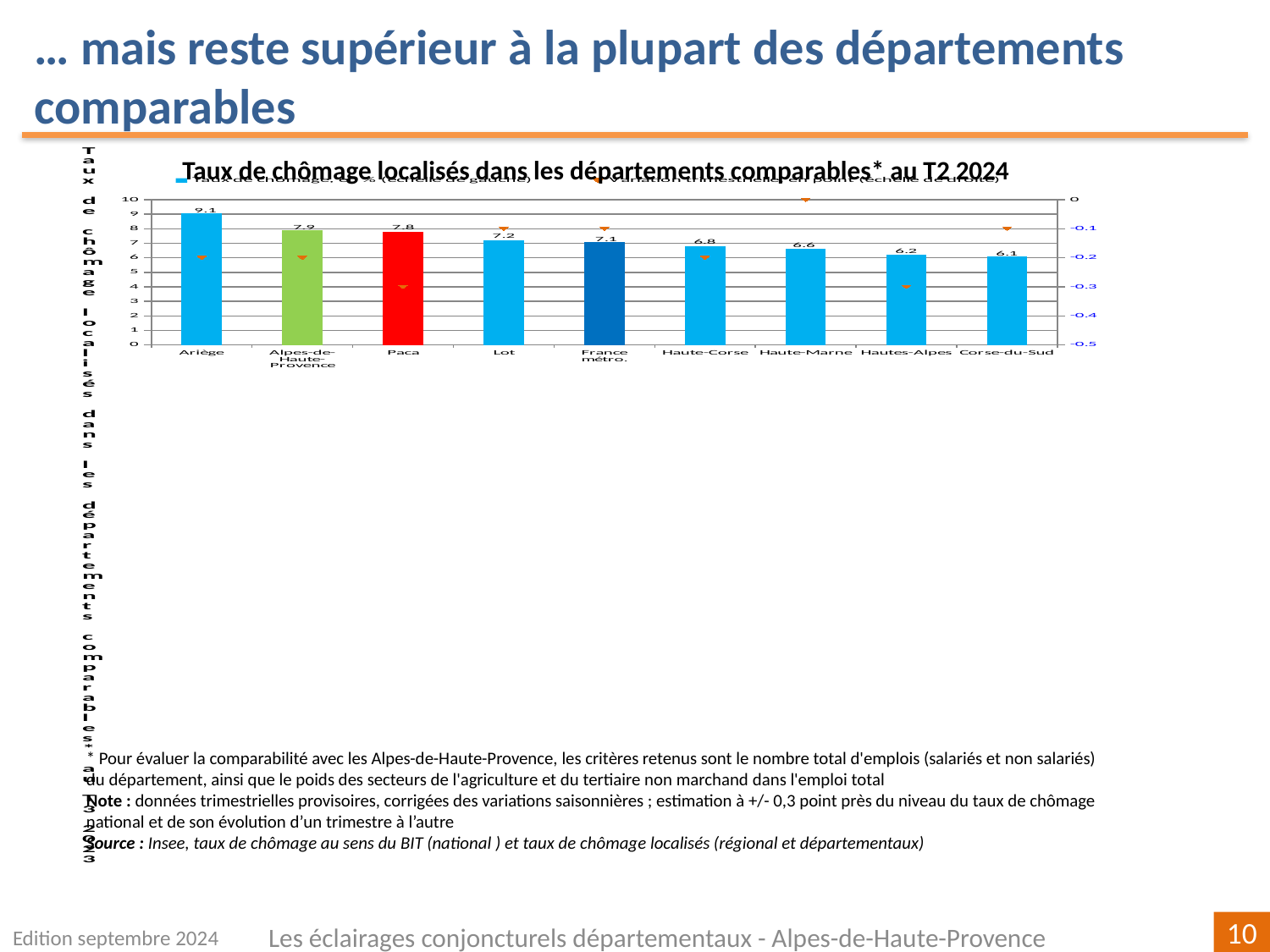
What type of chart is used to show the unemployment rates? Bar chart Which has a higher unemployment rate, Lot or Haute-Corse? Lot What is the value shown for Corse-du-Sud? 6.1 What is the unemployment rate shown for Ariège? 9.1 How many series does the chart legend list? 2 What is the difference between the unemployment rates of Ariège and Alpes-de-Haute-Provence? 1.2 Do the bar values rise or fall from left to right along the x axis? Fall What is the value shown for France métro.? 7.1 What is the unemployment rate shown for Alpes-de-Haute-Provence? 7.9 Which category has the lowest unemployment rate on the chart? Corse-du-Sud How many categories are shown on the x axis of the chart? 9 Which department has the highest unemployment rate on the chart? Ariège